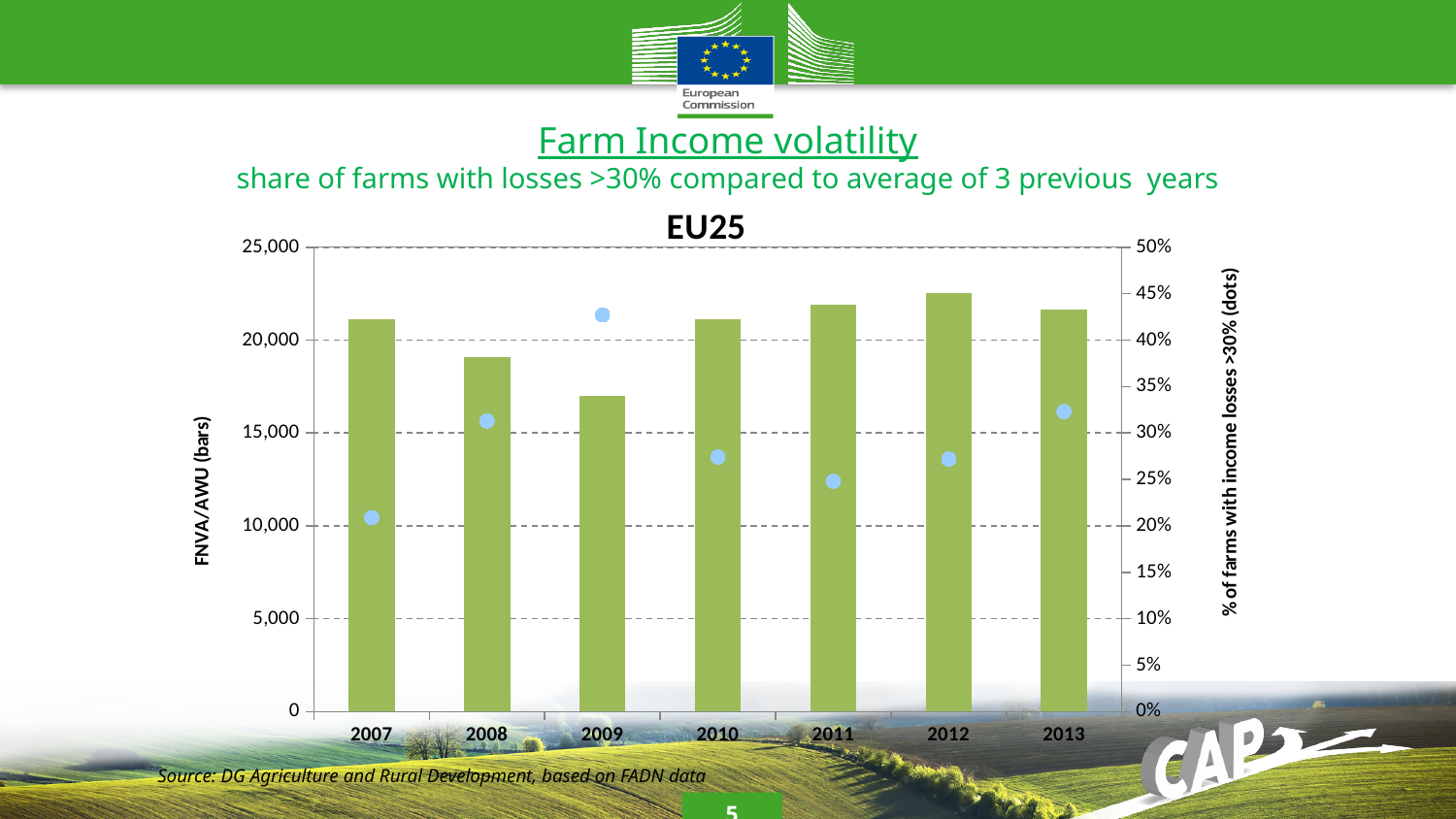
What is the label of the left vertical axis of the EU25 chart? FNVA/AWU (bars) Is the FNVA/AWU bar for 2009 greater or less than 20,000? less How many years are shown on the x axis of the EU25 chart? 7 Which year has the highest FNVA/AWU bar in the EU25 chart? 2012 Is the FNVA/AWU bar for 2012 greater or less than 20,000? greater Which year has the highest dot for % of farms with income losses >30%? 2009 Is the dot for % of farms with income losses >30% in 2007 greater or less than 25%? less Which year has the higher dot for % of farms with income losses >30%, 2008 or 2010? 2008 Which year has the larger FNVA/AWU bar, 2009 or 2010? 2010 Which year has the lowest dot for % of farms with income losses >30%? 2007 Which year has the lowest FNVA/AWU bar in the EU25 chart? 2009